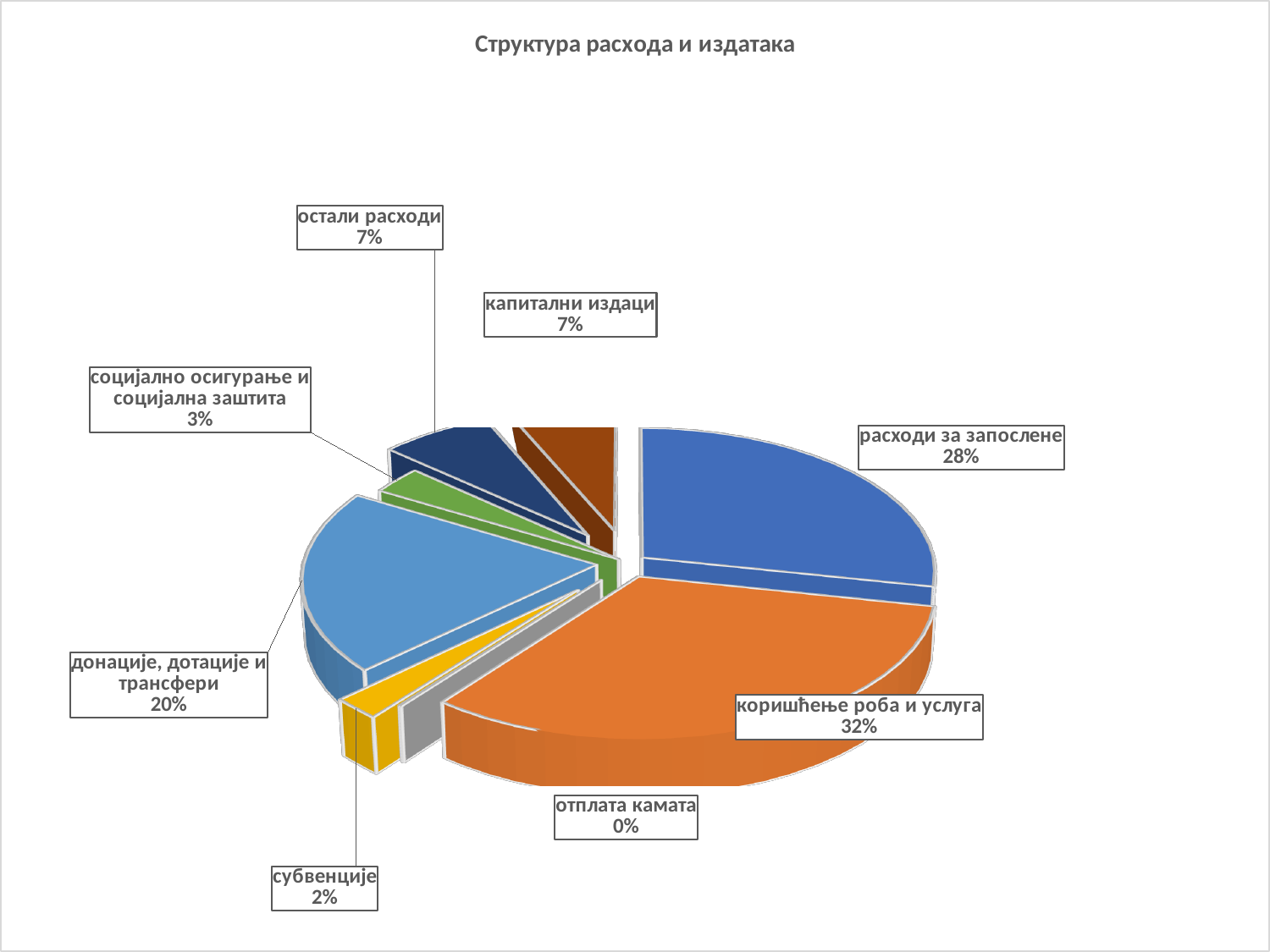
What is the value shown for субвенције? 2% Which category has the largest share of the pie? коришћење роба и услуга What is the title of the chart? Структура расхода и издатака What is the value shown for социјално осигурање и социјална заштита? 3% Which category has the smallest share of the pie? отплата камата What share of the pie does расходи за запослене have? 28% What is the value shown for отплата камата? 0% What type of chart is shown on the slide? pie chart What share of the pie does коришћење роба и услуга have? 32% What is the difference between the shares of коришћење роба и услуга and расходи за запослене? 4% What share of the pie does донације, дотације и трансфери have? 20% How many categories are shown in the pie chart? 8